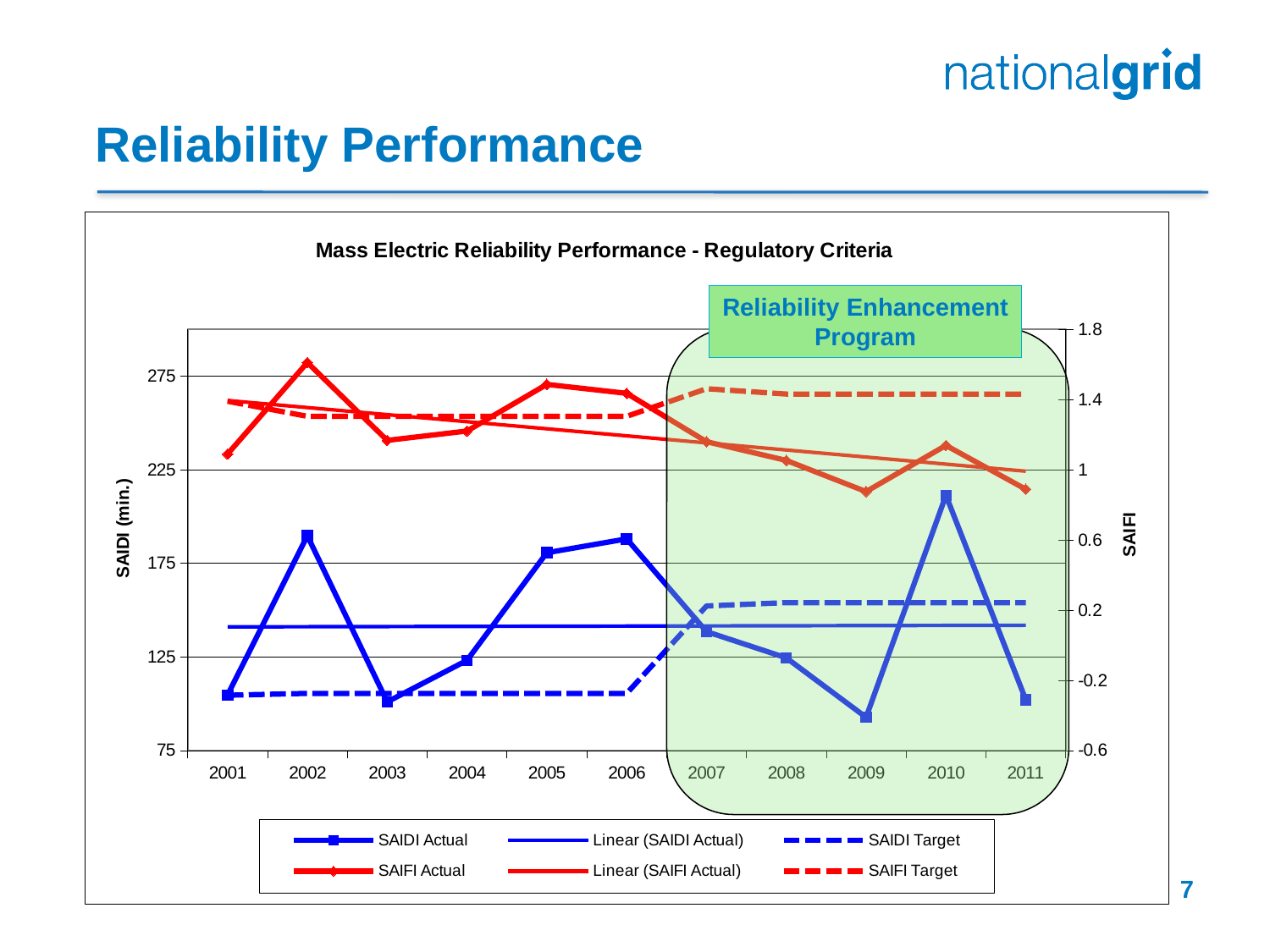
How many years are shown on the x axis? 11 What is the title of the chart? Mass Electric Reliability Performance - Regulatory Criteria Does the Linear (SAIFI Actual) trend line rise or fall from 2001 to 2011? fall Is the SAIFI Actual value for 2002 greater or less than 1.4? greater In which year is SAIDI Actual highest? 2010 In which year is SAIFI Actual highest? 2002 Which is larger, SAIDI Actual in 2002 or SAIDI Actual in 2010? 2010 Is the SAIDI Actual value for 2010 greater or less than 200? greater How many series does the legend list? 6 In which year is SAIDI Actual lowest? 2009 Is the SAIDI Actual value for 2009 greater or less than 100? less What kind of chart is shown on the slide? line chart